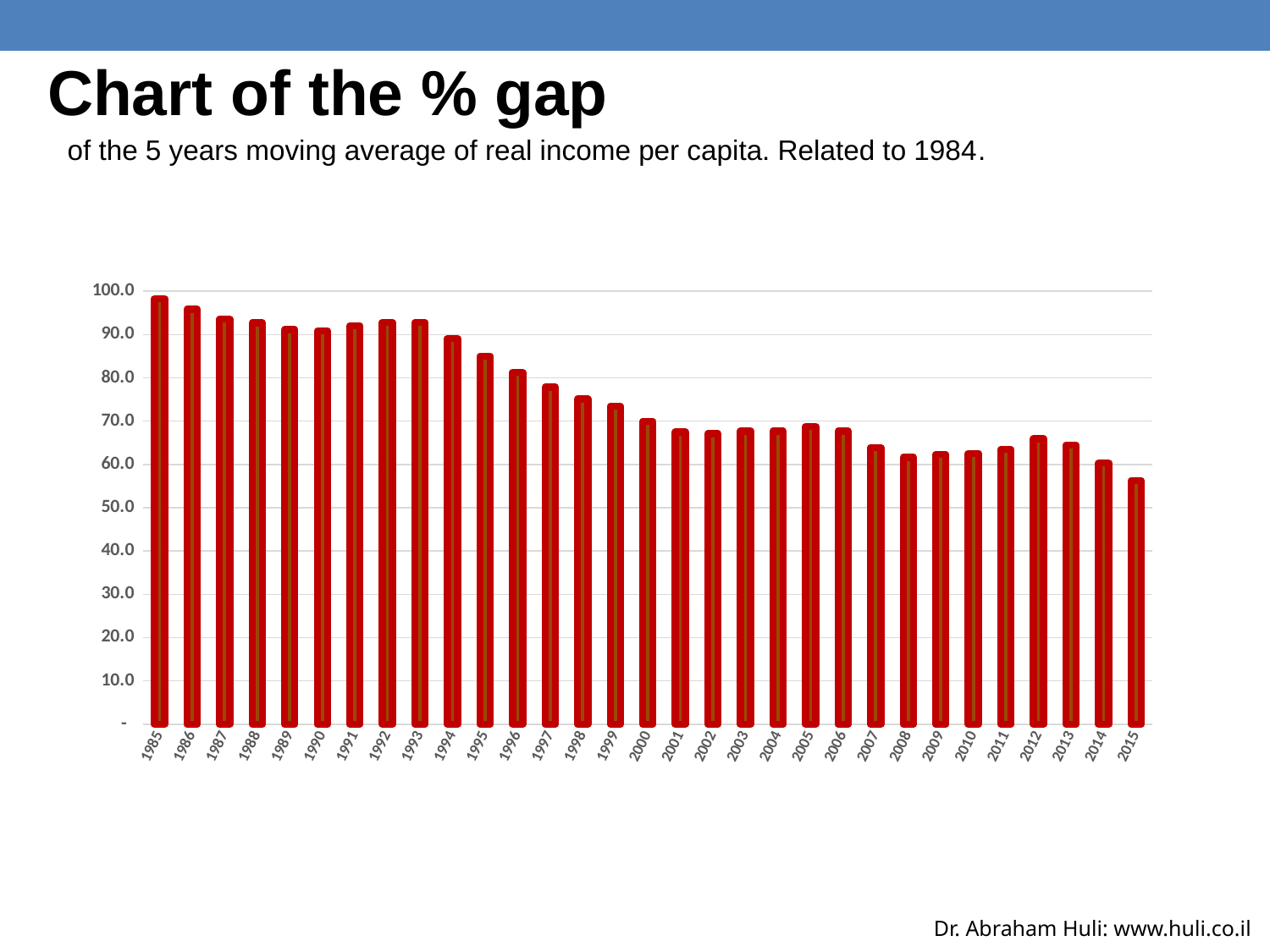
Is the value for 1985 greater or less than 90.0? greater Which year has the lowest value on the chart? 2015 Is the value for 1994 greater or less than 80.0? greater Is the value for 2000 greater or less than 60.0? greater Do the values generally rise or fall from 1985 to 2015? fall What is the title of the slide containing the chart? Chart of the % gap How many years (bars) are plotted on the chart? 31 Which year has the larger value, 1994 or 2000? 1994 What kind of chart is shown on the slide? bar chart Which year has the highest value on the chart? 1985